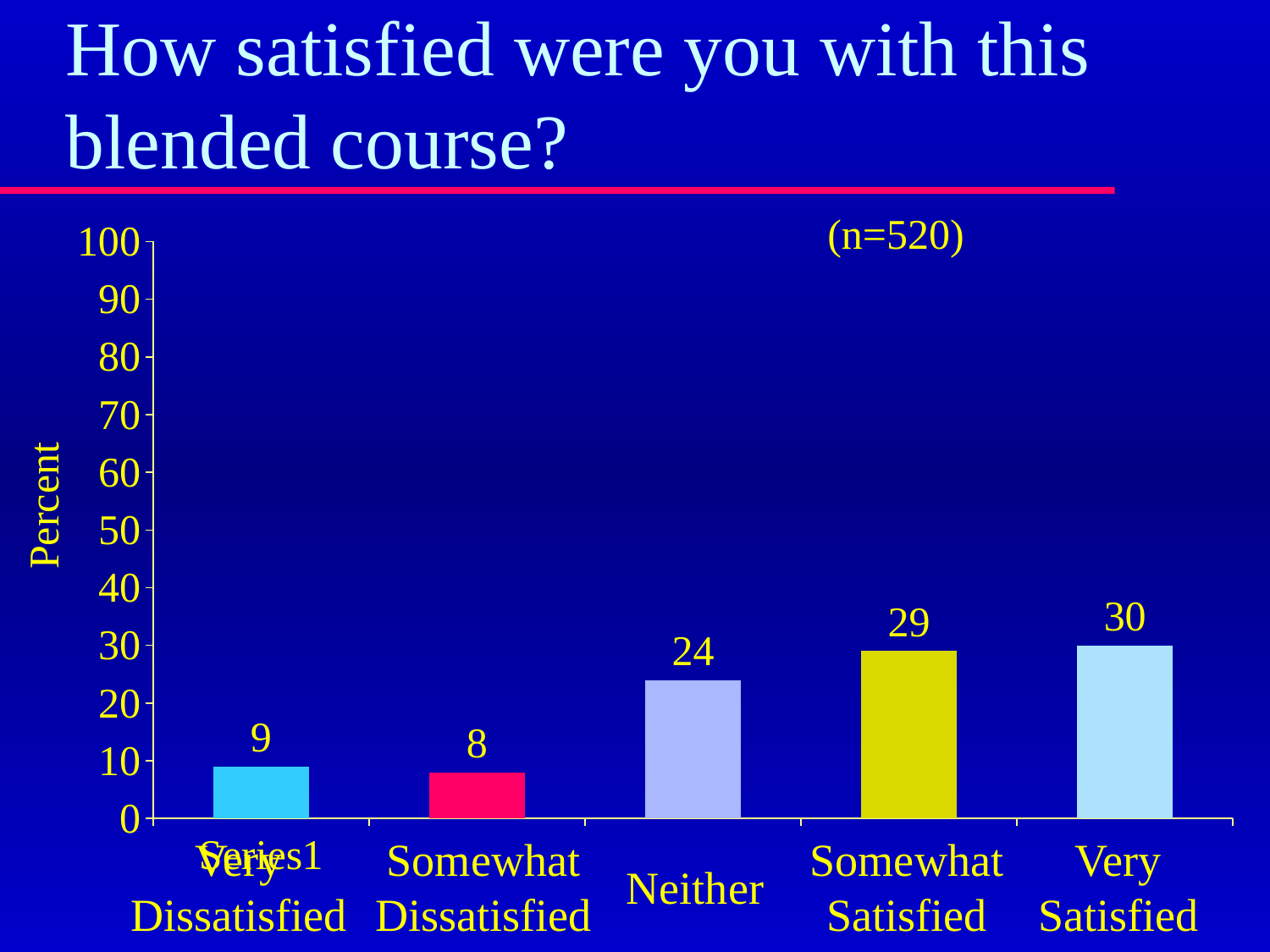
What kind of chart is shown on the slide? Bar chart What is the value for Somewhat Dissatisfied? 8 What sample size is shown on the chart? n=520 What is the value for Very Satisfied? 30 What is the label of the y axis? Percent Which category has the lowest value? Somewhat Dissatisfied What is the difference between the values for Very Satisfied and Neither? 6 What is the value for Somewhat Satisfied? 29 How many categories are shown on the x axis? 5 Which category has the highest value? Very Satisfied Which is larger, the value for Somewhat Satisfied or the value for Very Satisfied? Very Satisfied What is the value for Neither? 24